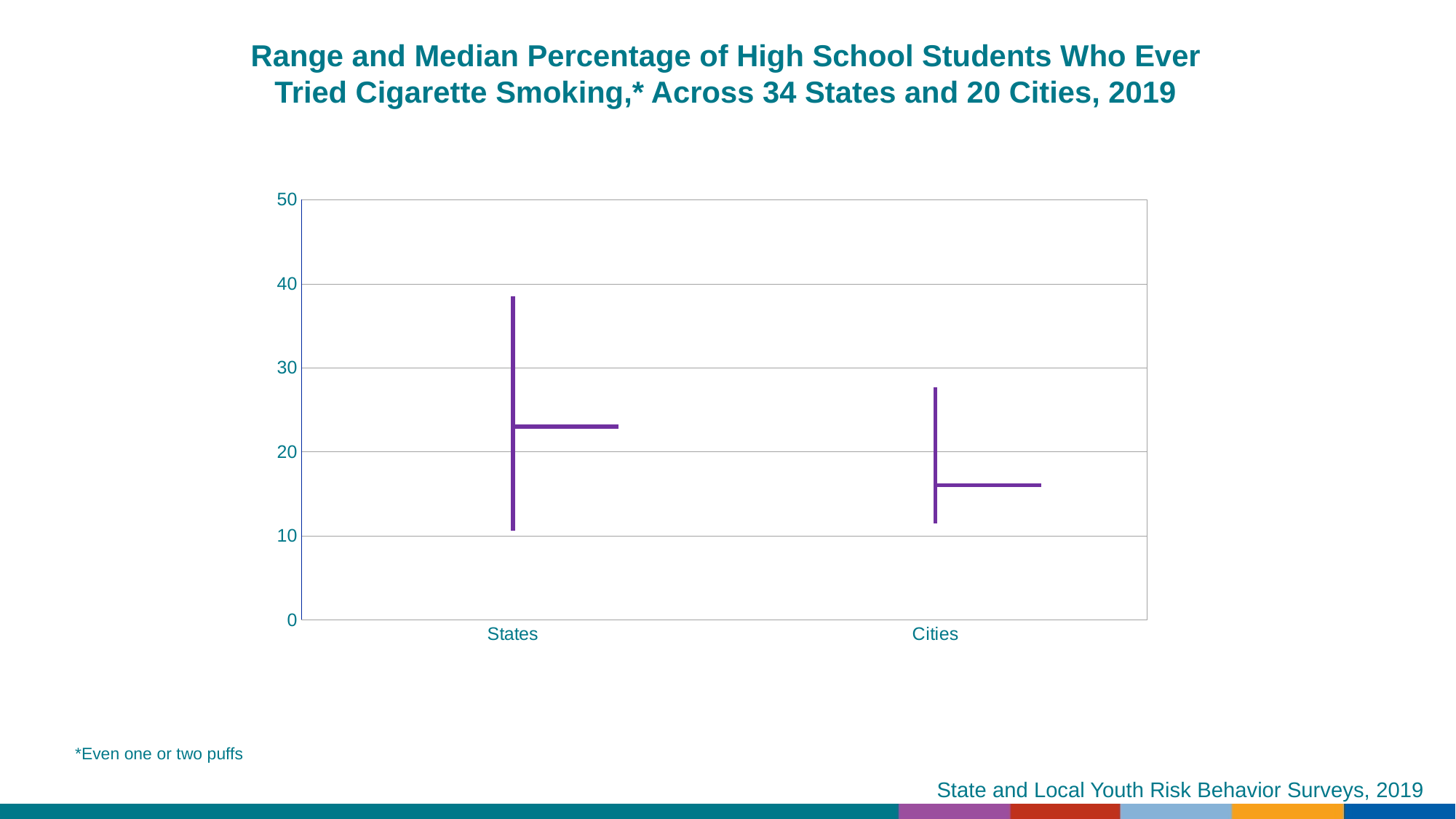
How many categories are shown on the x axis? 2 Which category has the higher maximum value in its range? States Is the median value for States greater or less than 20? greater Which category shows the wider range of values? States According to the footnote, what does the asterisk in the title mean? Even one or two puffs Which category has the higher median percentage, States or Cities? States Is the bottom of the range for States greater or less than 20? less Is the median value for Cities greater or less than 20? less What is the highest value shown on the y axis? 50 How many states and cities does the chart title say are included? 34 states and 20 cities